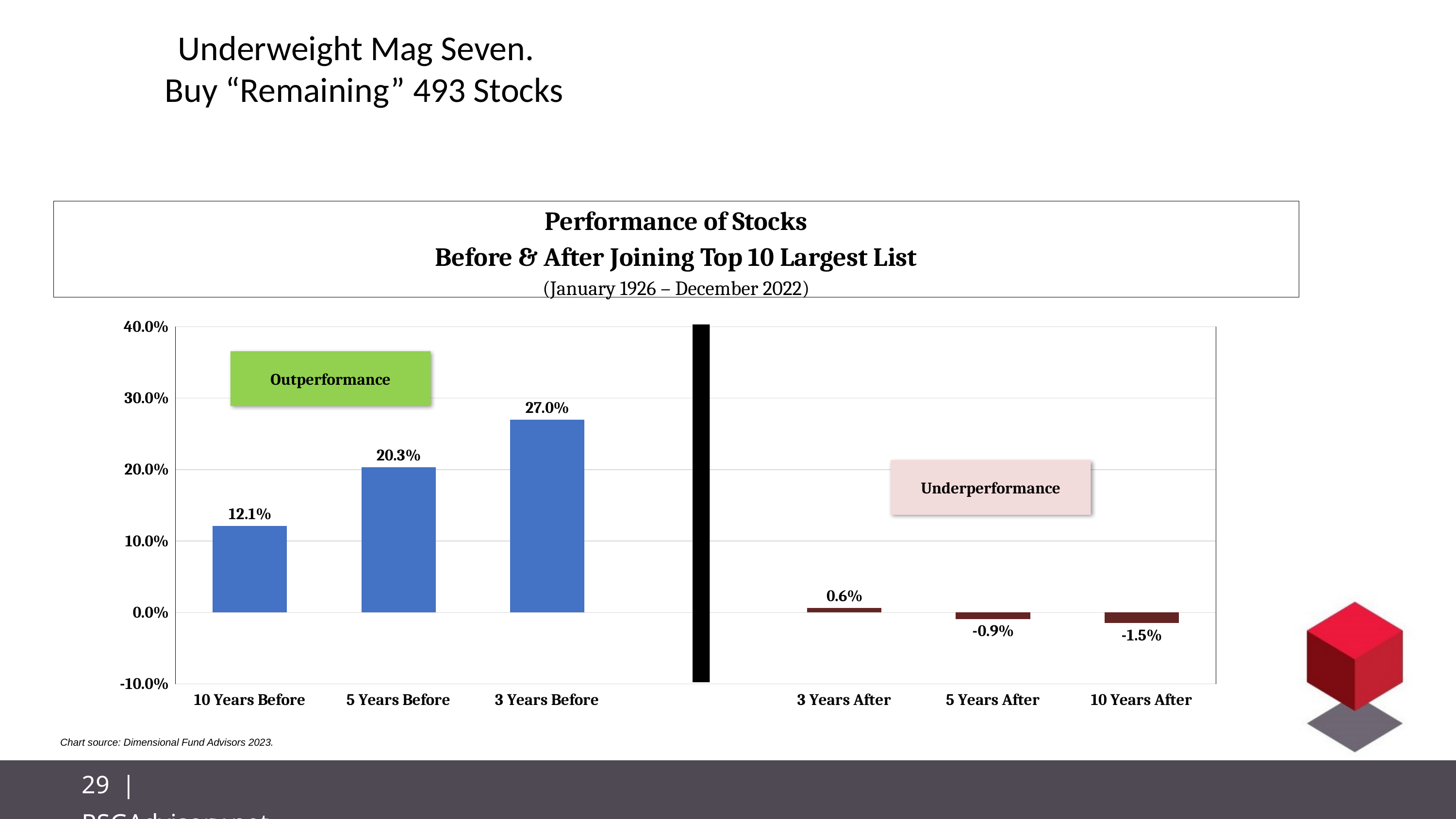
Is the value for 3 Years Before greater or less than 20.0%? greater What is the date range given in the chart title? January 1926 – December 2022 What is the value for 3 Years Before? 27.0% What is the value for 10 Years Before? 12.1% How many categories are shown on the x axis? 6 What is the value for 10 Years After? -1.5% What is the difference between the values for 3 Years Before and 5 Years Before? 6.7% What kind of chart is shown? Bar chart Which category has the highest value? 3 Years Before Which is larger, the value for 5 Years Before or the value for 3 Years After? 5 Years Before What is the value for 5 Years After? -0.9% Which category has the lowest value? 10 Years After